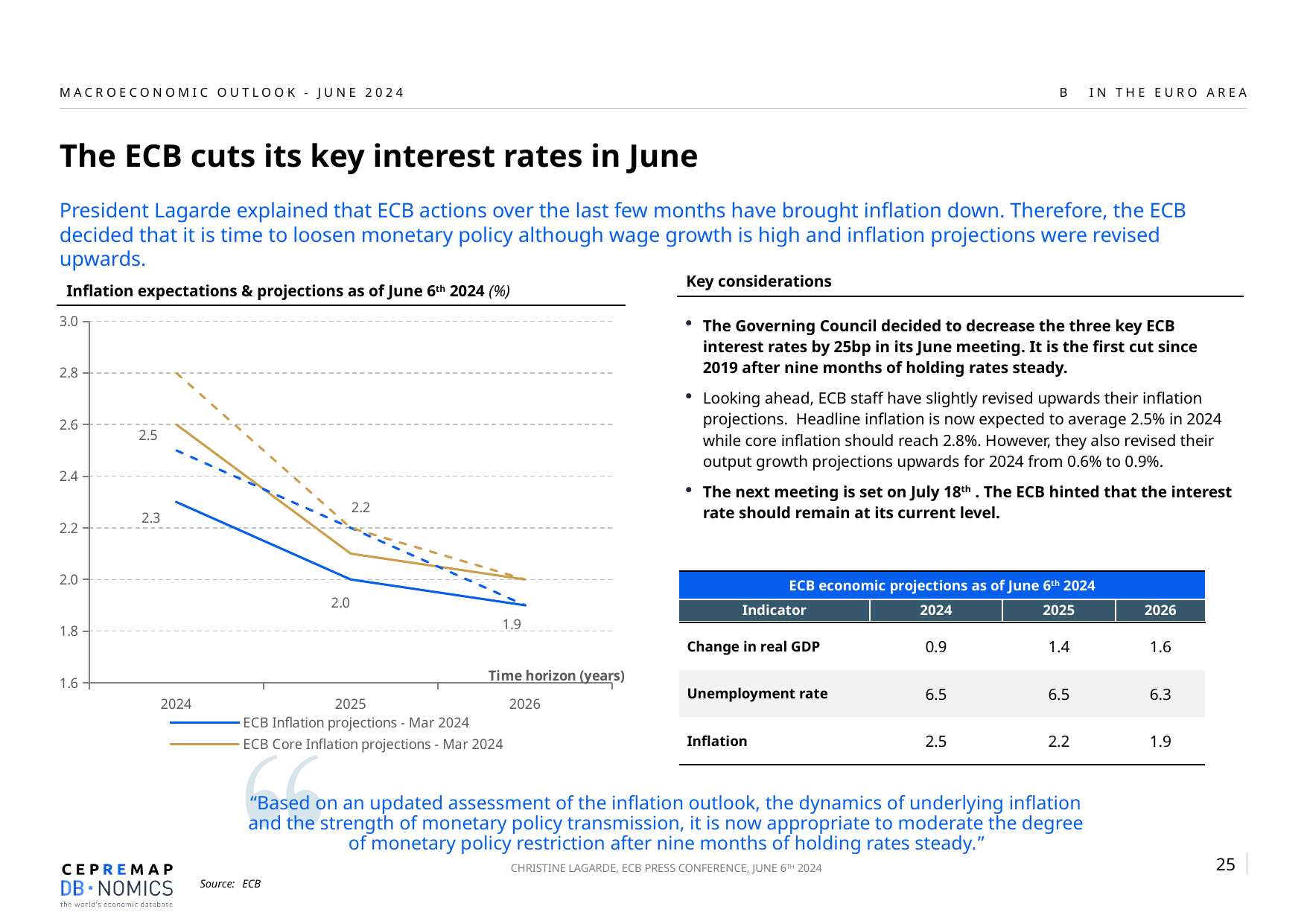
Is the value of 'ECB Core Inflation projections - Mar 2024' for 2026 greater or less than 1.8? greater What is the value of the 'ECB Inflation projections - Mar 2024' series for 2025? 2.0 Do the lines in the chart rise or fall as the time horizon moves from 2024 to 2026? fall How many series does the chart legend list? 2 What is the value of the 'ECB Inflation projections - Mar 2024' series for 2024? 2.3 In 2024, which is higher: 'ECB Core Inflation projections - Mar 2024' or 'ECB Inflation projections - Mar 2024'? ECB Core Inflation projections - Mar 2024 What is the label of the x axis of the chart? Time horizon (years) What colour is the 'ECB Core Inflation projections - Mar 2024' line in the chart? gold/brown By how much does the 'ECB Inflation projections - Mar 2024' series fall from 2024 to 2025? 0.3 What kind of chart is shown under the title 'Inflation expectations & projections as of June 6th 2024'? line chart Is the value of 'ECB Core Inflation projections - Mar 2024' for 2024 greater or less than 2.4? greater How many time horizon points are shown on the x axis of the chart? 3